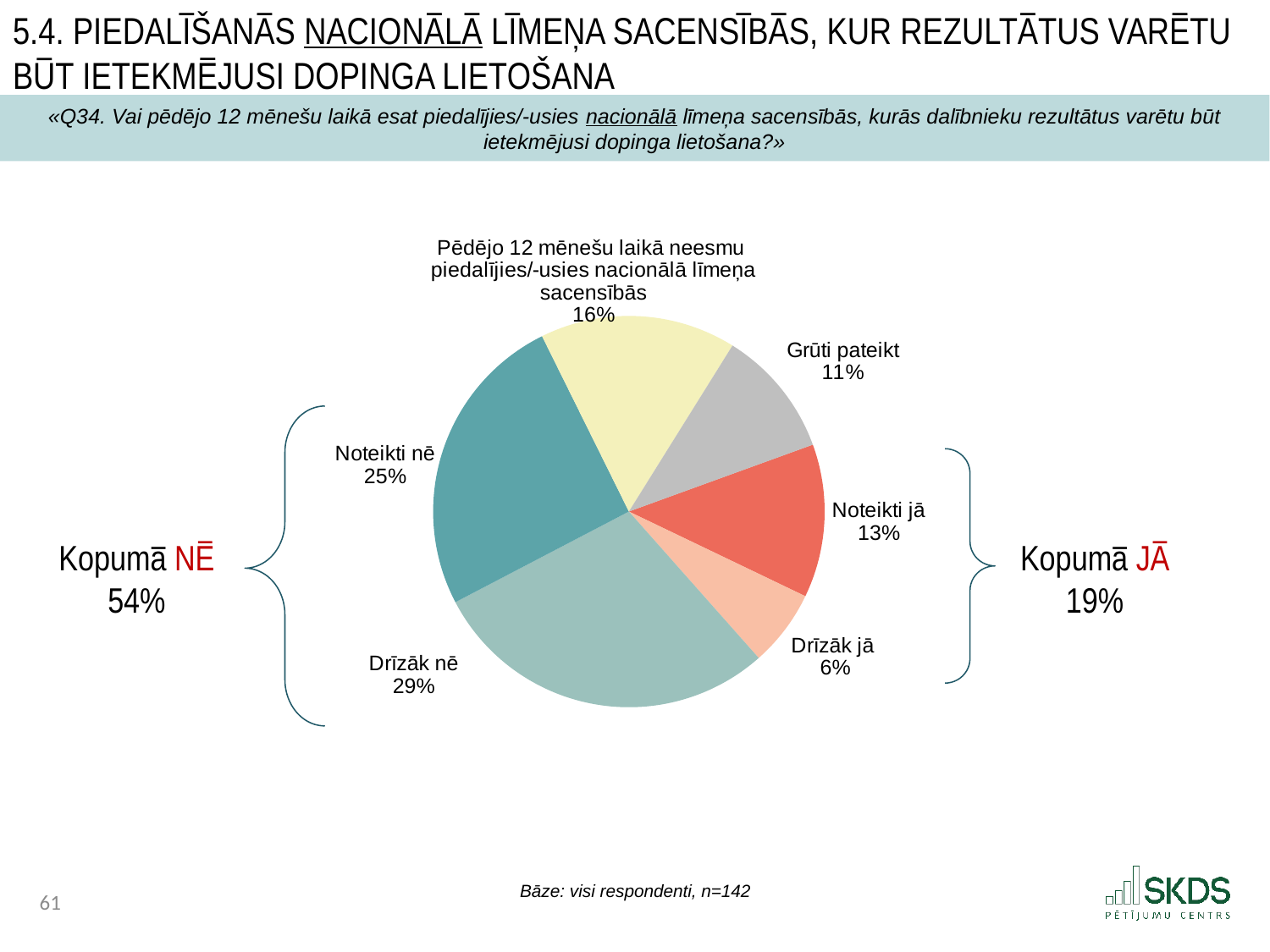
What is the combined share shown for "Kopumā JĀ"? 19% What is the value for "Noteikti jā"? 13% What is the value for "Drīzāk nē"? 29% What is the difference between "Noteikti nē" and "Noteikti jā"? 12% Which slice of the pie chart is the smallest? Drīzāk jā What is the combined share shown for "Kopumā NĒ"? 54% What is the value for "Grūti pateikt"? 11% What is the value for "Pēdējo 12 mēnešu laikā neesmu piedalījies/-usies nacionālā līmeņa sacensībās"? 16% Which is larger, "Grūti pateikt" or "Drīzāk jā"? Grūti pateikt Which slice of the pie chart is the largest? Drīzāk nē How many slices does the pie chart have? 6 What kind of chart is shown on the slide? pie chart